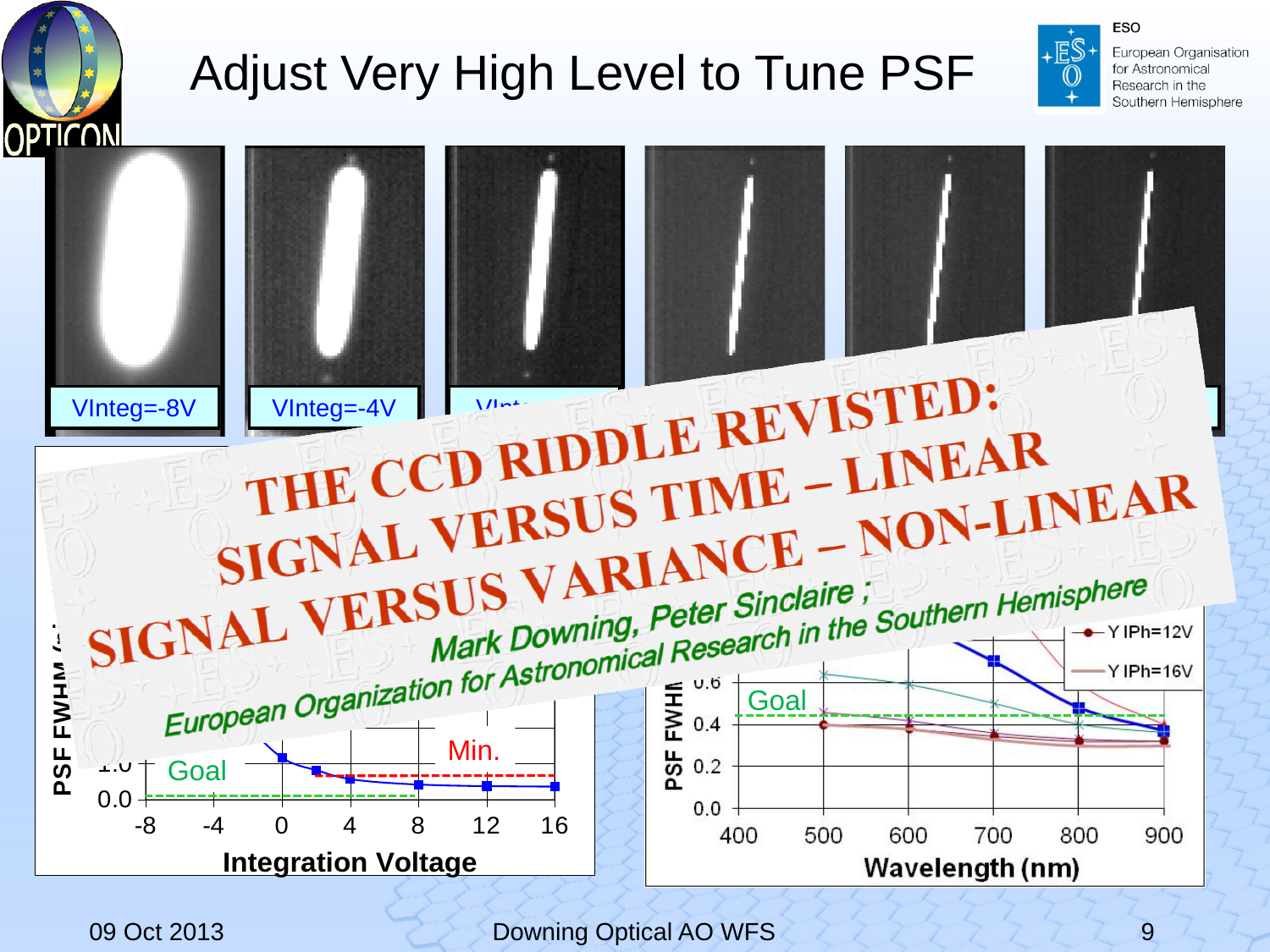
What is the x-axis title of the right chart? Wavelength (nm) In the left chart, is the PSF FWHM value at an integration voltage of 16 greater or less than 1.0? less What kind of chart is the right chart (PSF FWHM versus Wavelength)? line chart In the left chart, is the PSF FWHM value at an integration voltage of 8 greater or less than 1.0? less What kind of chart is the left chart (PSF FWHM versus Integration Voltage)? line chart In the right chart, is the Y IPh=12V value at 700 nm greater or less than 0.6? less In the right chart, does the Y IPh=12V line rise or fall as wavelength increases from 700 nm to 900 nm? fall What is the x-axis title of the left chart? Integration Voltage In the left chart, does the blue PSF FWHM line rise or fall as the integration voltage increases? fall In the left chart, which is larger: the PSF FWHM at integration voltage 0 or at integration voltage 16? integration voltage 0